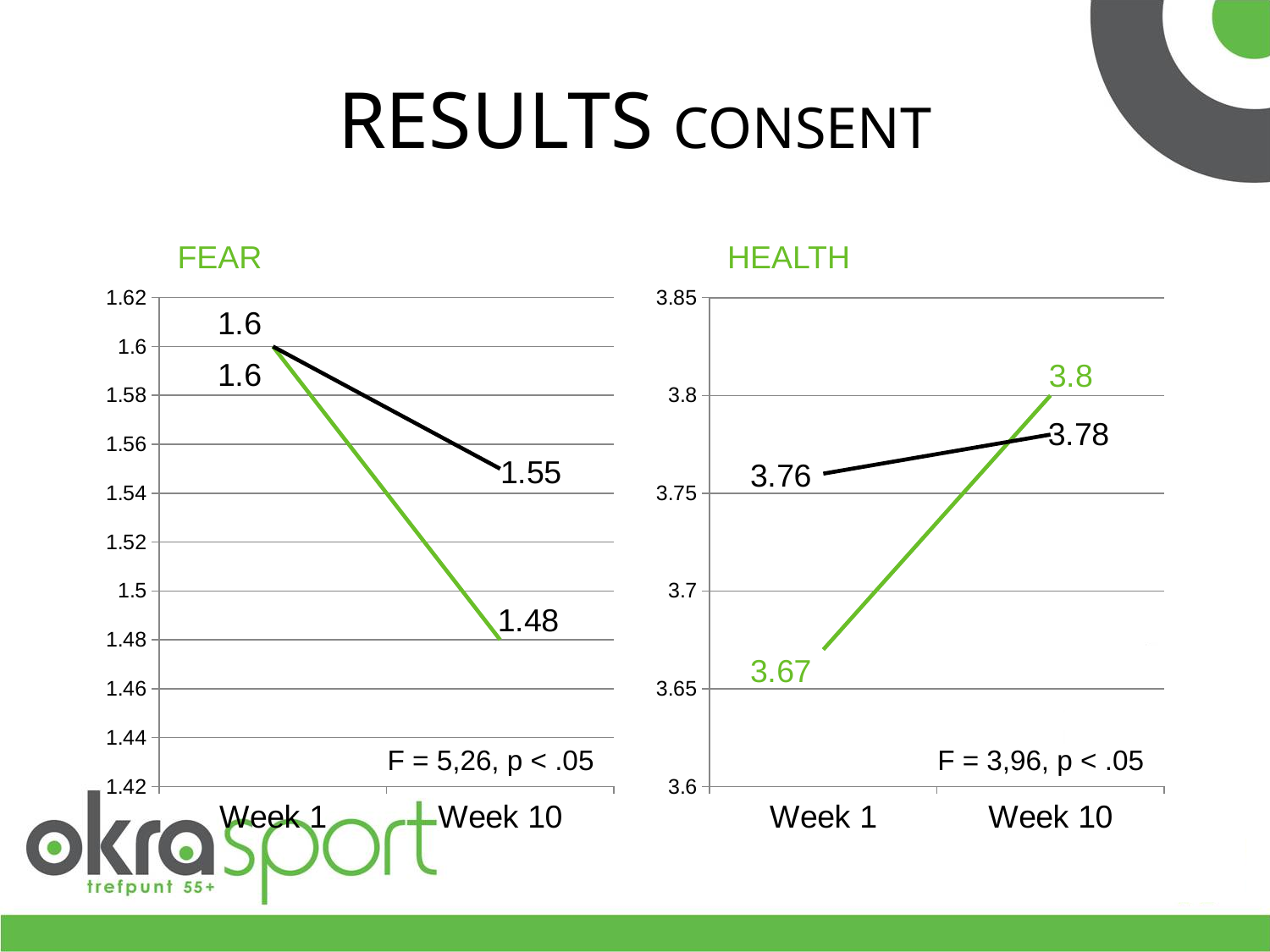
In the HEALTH chart, what is the value of the green line at Week 1? 3.67 What kind of chart is the FEAR chart? line chart In the FEAR chart, by how much does the green line decrease from Week 1 to Week 10? 0.12 In the HEALTH chart, which line has the higher value at Week 10, the green or the black? green In the HEALTH chart, what is the value of the black line at Week 10? 3.78 In the FEAR chart, what is the value of the black line at Week 10? 1.55 In the HEALTH chart, does the green line rise or fall from Week 1 to Week 10? rise In the FEAR chart, does the green line rise or fall from Week 1 to Week 10? fall How many x-axis categories does the HEALTH chart have? 2 What F statistic is printed on the HEALTH chart? F = 3,96, p < .05 In the FEAR chart, what is the value of the green line at Week 10? 1.48 In the HEALTH chart, what is the difference between the green and black lines at Week 1? 0.09